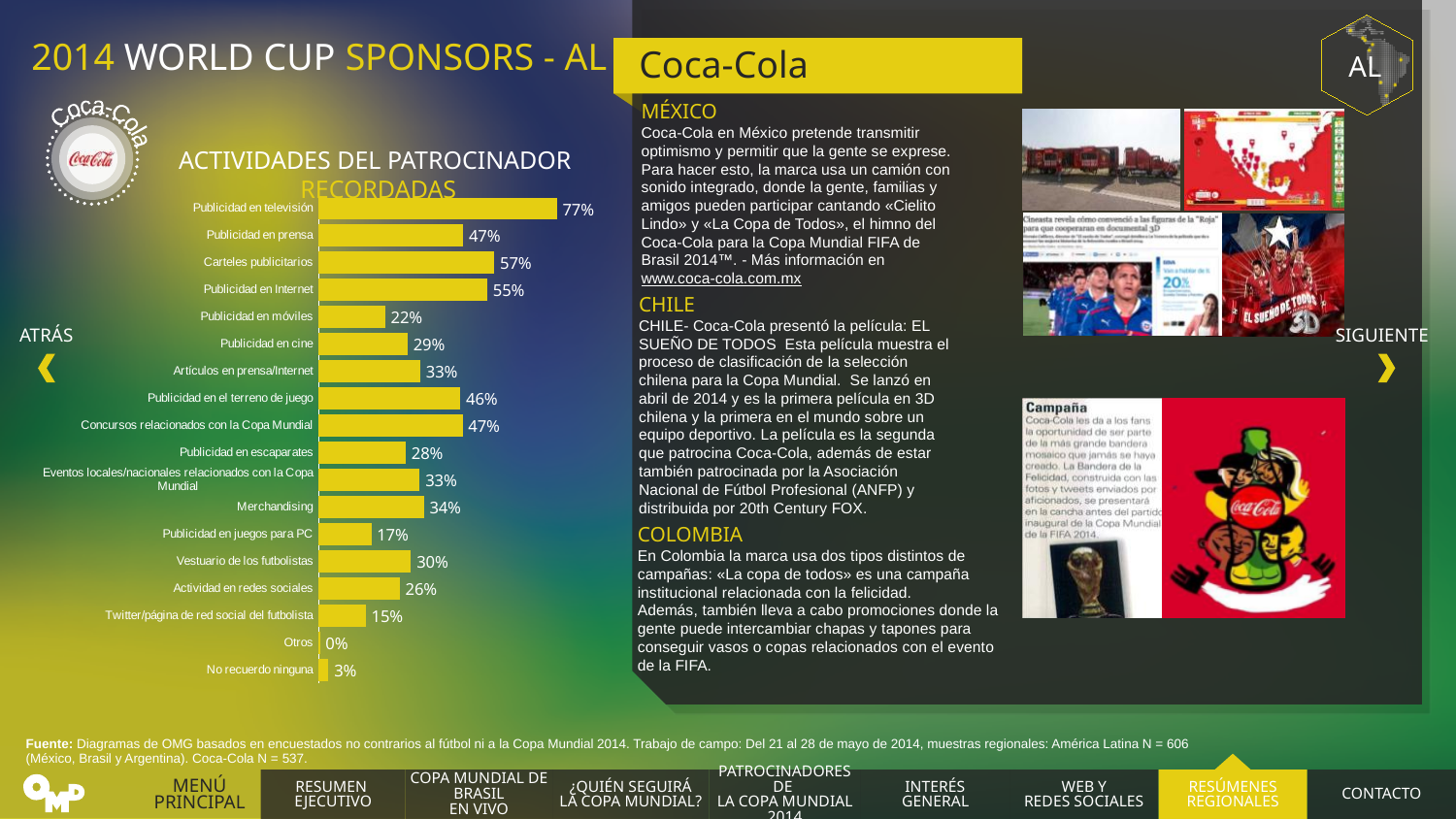
What is the value for Vestuario de los futbolistas? 30% What is the difference between Merchandising and Actividad en redes sociales? 8% What is the difference between Publicidad en televisión and Publicidad en Internet? 22% What is the value for Publicidad en juegos para PC? 17% How many categories does the chart show? 18 Which category has the lowest value? Otros What is the value for Publicidad en televisión? 77% Which category has the highest value? Publicidad en televisión What is the value for Carteles publicitarios? 57% What is the title of the chart? ACTIVIDADES DEL PATROCINADOR RECORDADAS What kind of chart is shown on the slide? Bar chart Which is larger, Publicidad en móviles or Publicidad en cine? Publicidad en cine